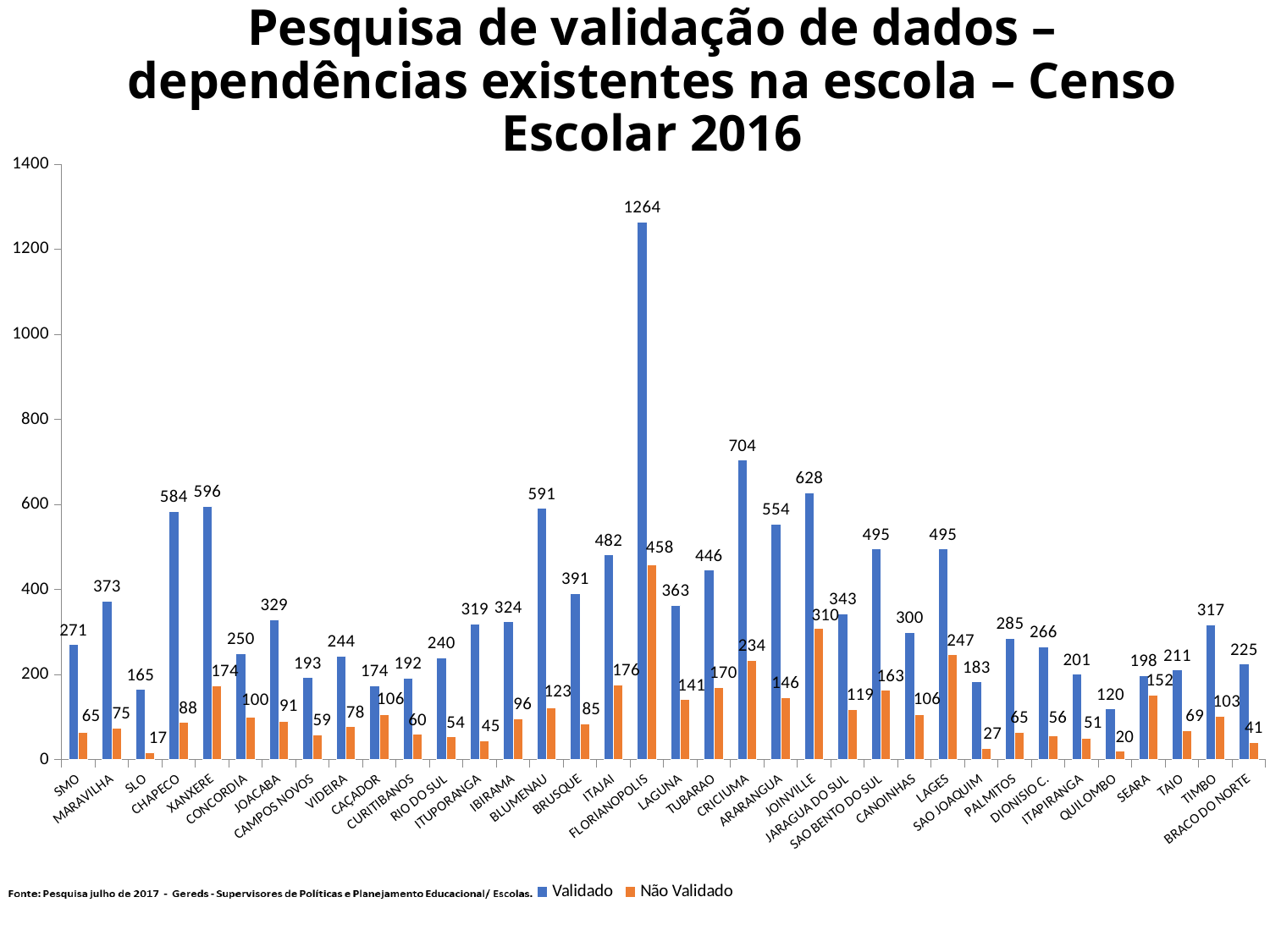
How many categories are shown on the x axis? 36 Which category has the lowest Validado value? QUILOMBO What is the Não Validado value for JOINVILLE? 310 What is the Validado value for CRICIUMA? 704 What is the difference between the Validado and Não Validado values for XANXERE? 422 Which category has the highest Validado value? FLORIANOPOLIS What kind of chart is shown on the slide? Bar chart Which category has the lowest Não Validado value? SLO What is the Validado value for FLORIANOPOLIS? 1264 What colour are the Não Validado bars? Orange Which is larger, the Validado value for CHAPECO or the Validado value for BLUMENAU? BLUMENAU How many series does the legend list? 2